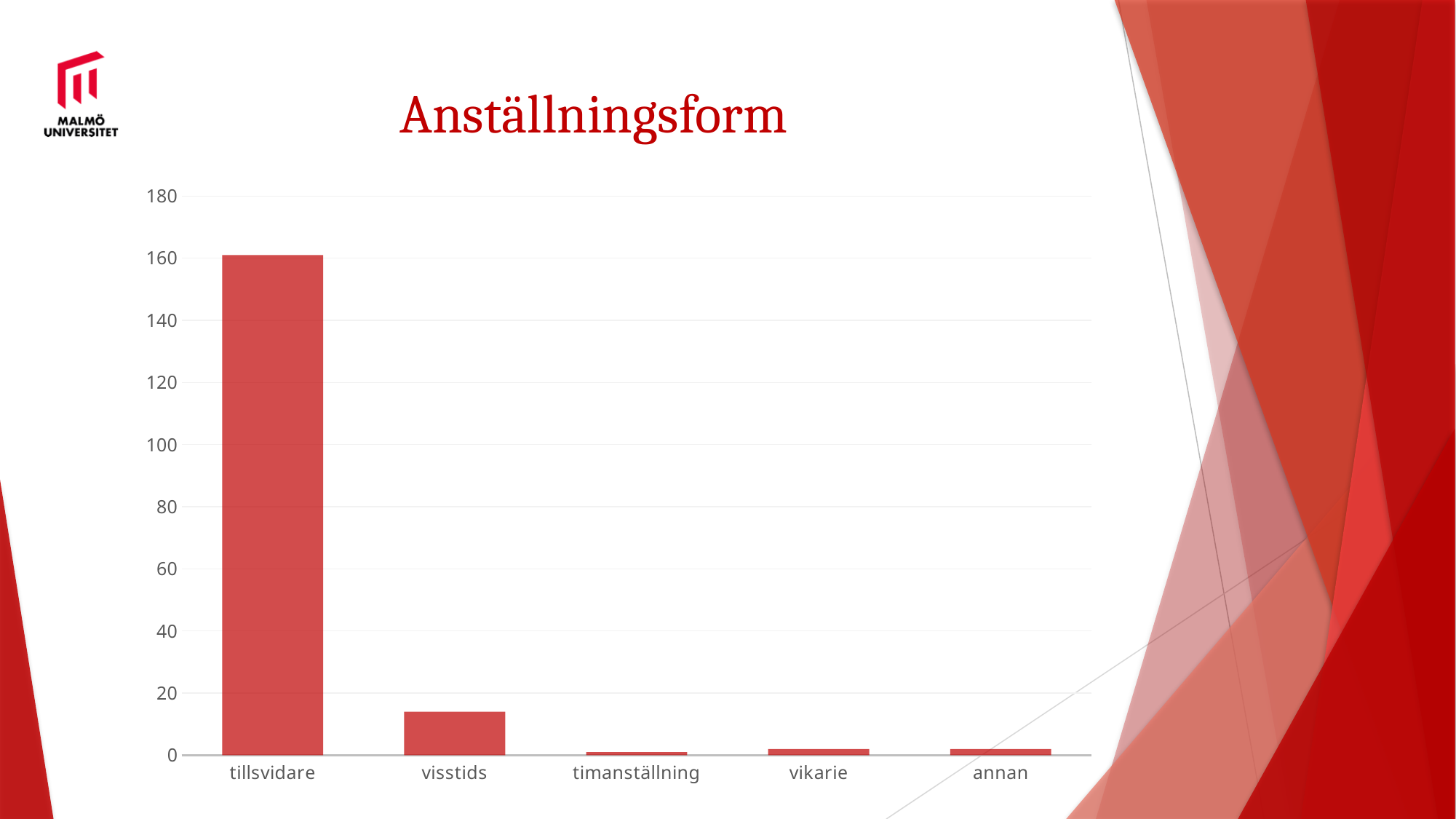
What is the highest value shown on the y axis of the chart? 180 Is the value for annan greater or less than 40? less Is the value for tillsvidare greater or less than 180? less What kind of chart is shown on the slide? bar chart Is the value for vikarie greater or less than 20? less Which is larger, the value for visstids or the value for vikarie? visstids How many categories are shown on the x axis of the chart? 5 What is the title of the chart? Anställningsform Which is larger, the value for tillsvidare or the value for visstids? tillsvidare Which category has the highest value in the chart? tillsvidare